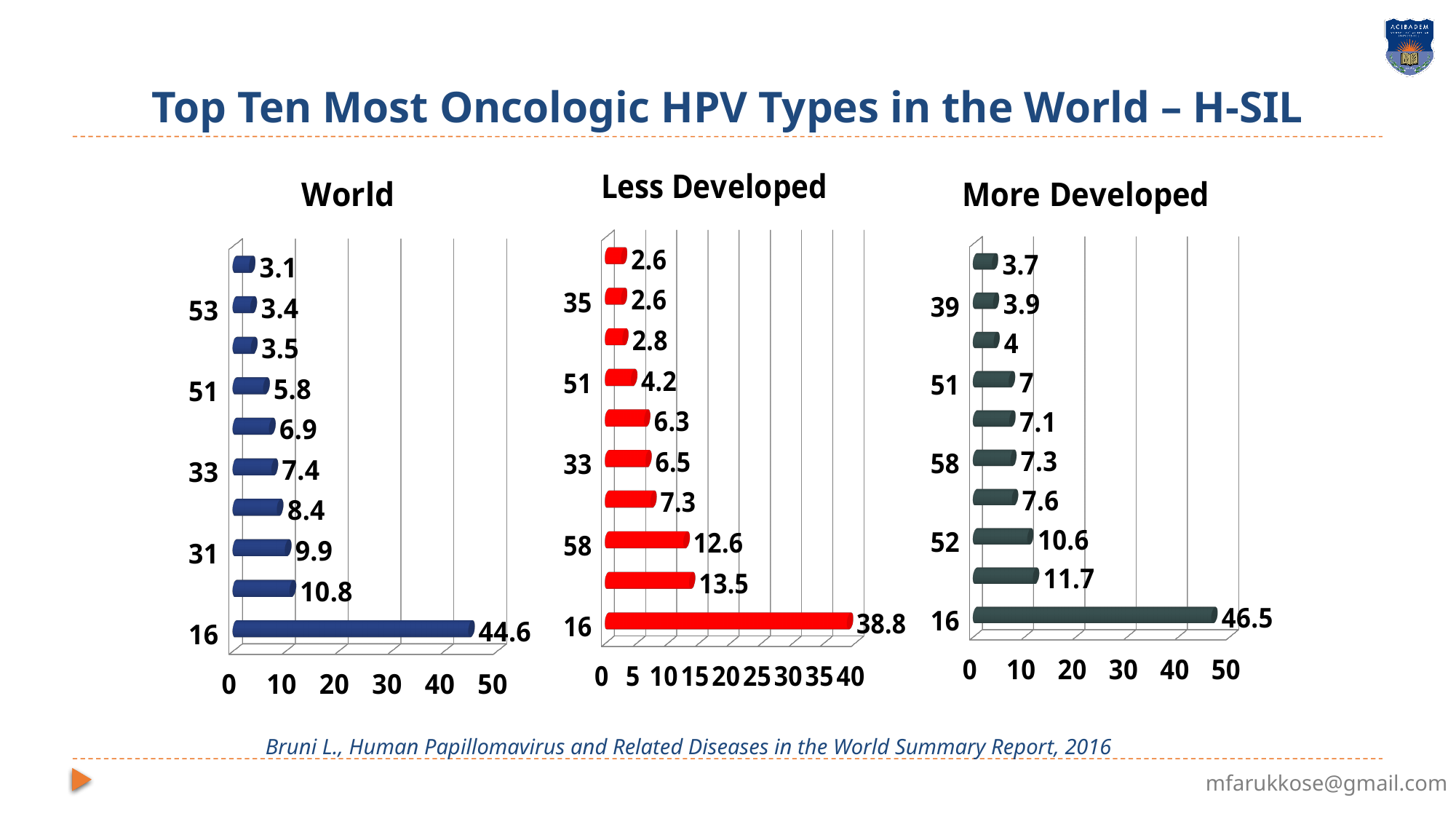
What kind of chart is the Less Developed chart? Bar chart Which is larger: the value for HPV type 16 in the Less Developed chart or in the More Developed chart? More Developed In the More Developed chart, what is the value for HPV type 52? 10.6 How many bars are plotted in the World chart? 10 In the Less Developed chart, what is the value for HPV type 58? 12.6 In the World chart, what is the value for HPV type 16? 44.6 In the World chart, what is the value for HPV type 31? 9.9 What colour are the bars in the Less Developed chart? Red In the More Developed chart, what is the difference between the values for HPV type 58 and HPV type 51? 0.3 In the More Developed chart, which HPV type has the highest value? 16 In the World chart, what is the difference between the values for HPV type 16 and HPV type 31? 34.7 In the Less Developed chart, which labelled HPV type has the lowest value? 35